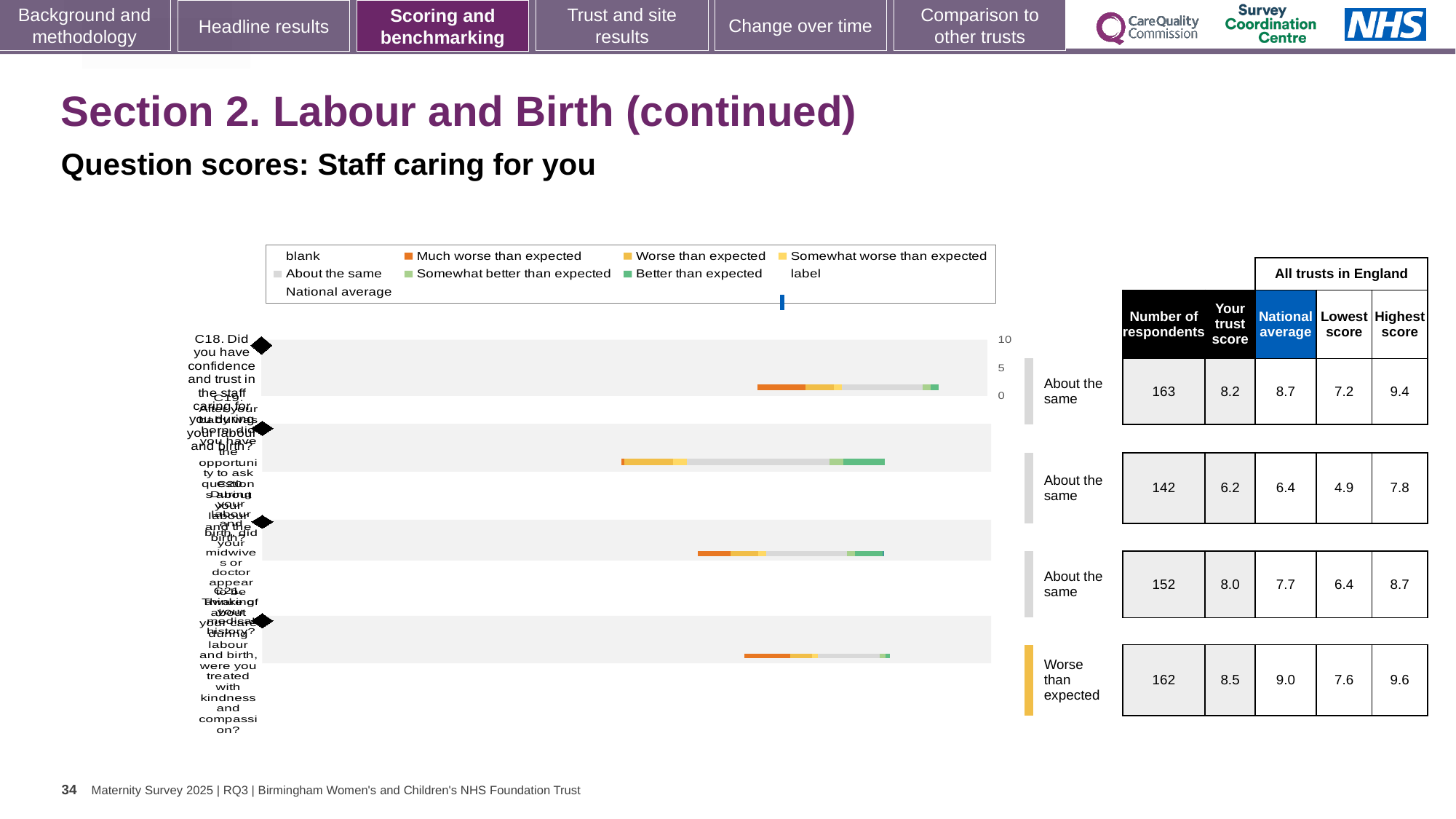
Which row is labelled 'Worse than expected' beside the chart? the fourth (bottom) row What is the difference between the national average and the trust score in the fourth (bottom) row? 0.5 Which table row has the highest 'Your trust score'? the fourth (bottom) row, 8.5 In the table, what is the trust score for the second row? 6.2 In the table, what is the national average for the fourth (bottom) row? 9.0 In the table, what is the number of respondents for the first (top) row? 163 In the third row, is the trust score or the national average larger? the trust score (8.0) Which table row has the lowest number of respondents? the second row, 142 In the table, what is the lowest score for the third row? 6.4 How many question rows are plotted in the chart? 4 What is the highest score shown in the table for the first (top) row? 9.4 What kind of chart is shown on the slide? bar chart